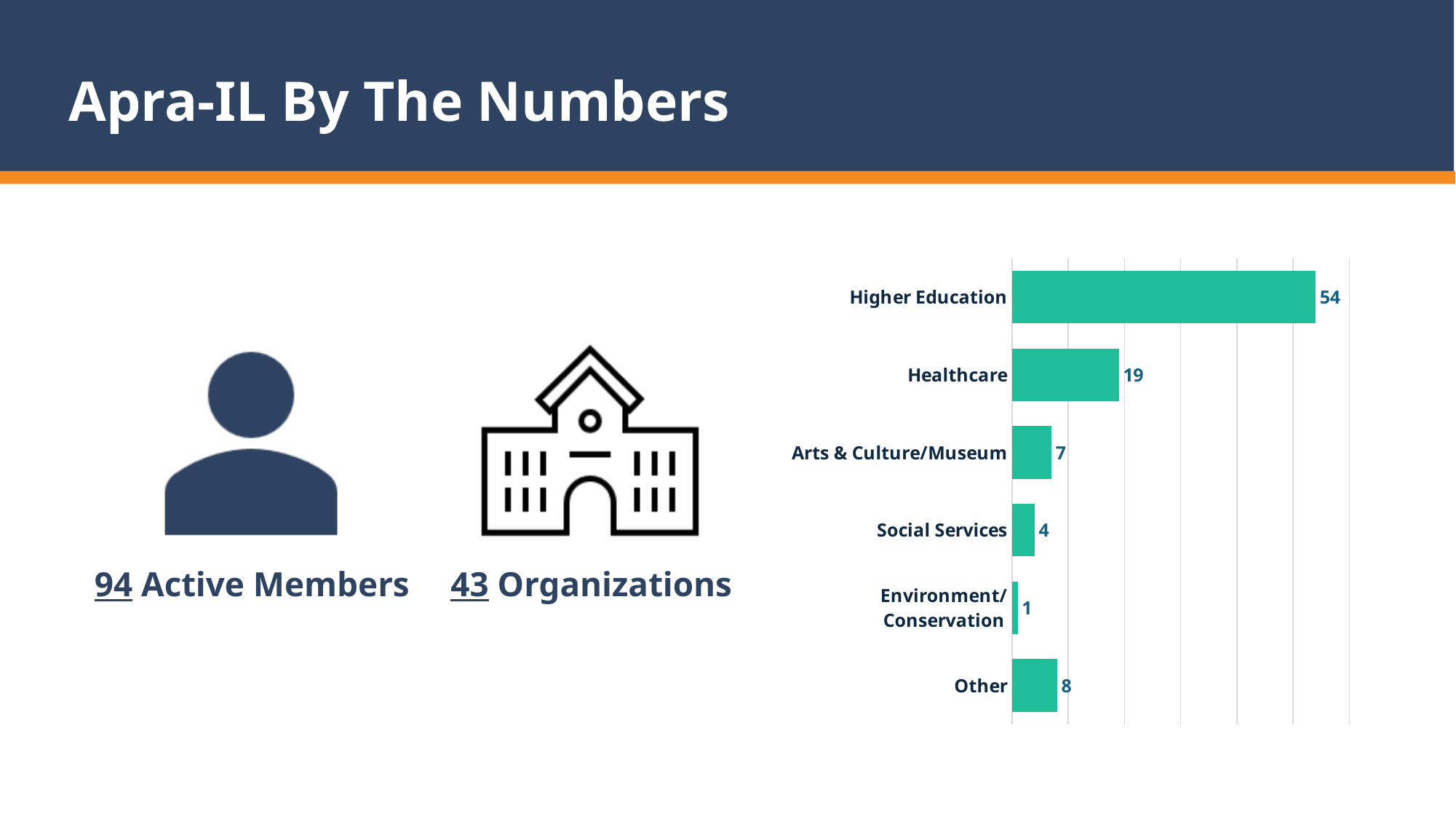
What is the value for Healthcare in the bar chart? 19 Which is larger, the value for Other or the value for Arts & Culture/Museum? Other What kind of chart is shown on the slide? Bar chart What is the value for Arts & Culture/Museum in the bar chart? 7 What is the difference between the values for Higher Education and Healthcare? 35 Which category has the highest value in the bar chart? Higher Education What is the value for Higher Education in the bar chart? 54 What is the difference between the values for Other and Social Services? 4 What is the value for Environment/Conservation in the bar chart? 1 What colour are the bars in the chart? Green How many categories are shown in the bar chart? 6 Which category has the lowest value in the bar chart? Environment/Conservation